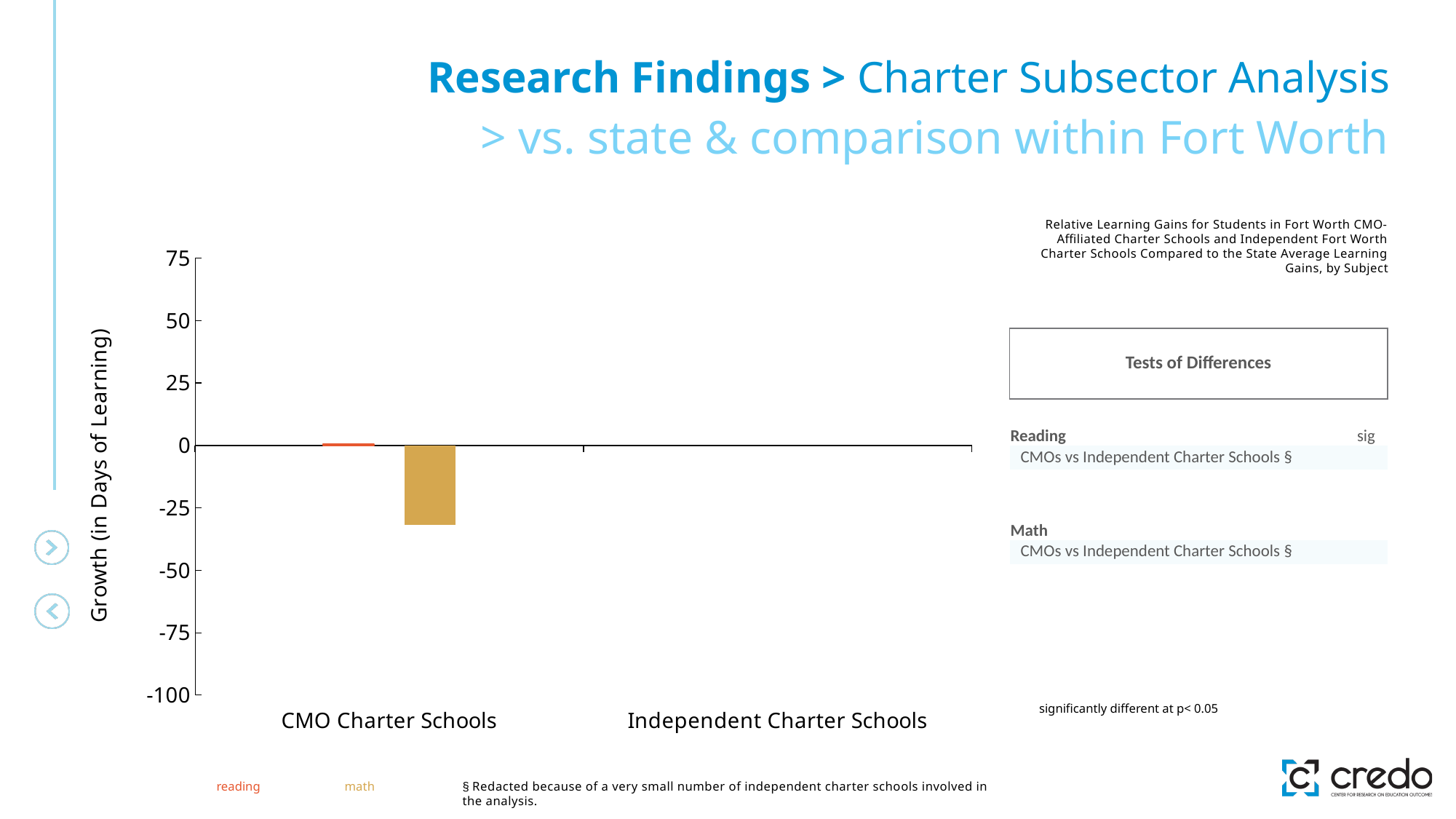
Is the math value for CMO Charter Schools greater or less than -25? less Is the reading value for CMO Charter Schools greater or less than 25? less How many categories are shown on the x axis? 2 What is the label on the y axis? Growth (in Days of Learning) Is the math value for CMO Charter Schools greater or less than -50? greater Which series is plotted in the negative direction for CMO Charter Schools? math What is the lowest value shown on the y axis? -100 For CMO Charter Schools, which is larger, the reading value or the math value? reading What kind of chart is shown on the slide? bar chart Which category has no bars plotted? Independent Charter Schools How many series does the legend list? 2